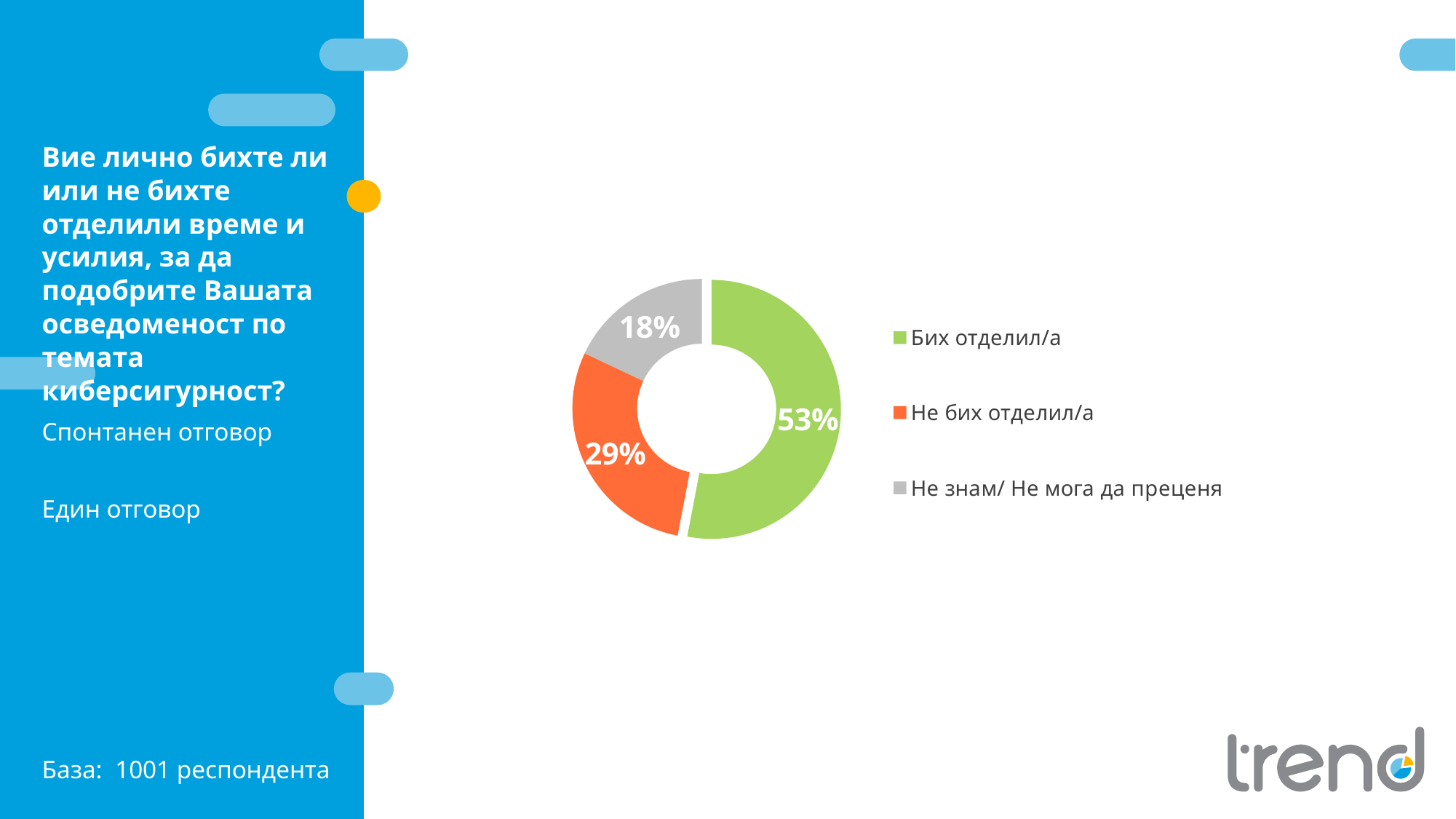
What kind of chart is shown on the slide? Pie (doughnut) chart What is the difference in percentage points between "Не бих отделил/а" and "Не знам/ Не мога да преценя"? 11 What share of respondents answered "Не бих отделил/а"? 29% What colour is the slice for "Не бих отделил/а"? Orange Which answer category has the largest share? Бих отделил/а Which answer category has the smallest share? Не знам/ Не мога да преценя What share of respondents answered "Бих отделил/а"? 53% How many categories does the chart show? 3 How many respondents form the base of the survey shown on the slide? 1001 Which is larger: the share for "Не бих отделил/а" or for "Не знам/ Не мога да преценя"? Не бих отделил/а What share of respondents answered "Не знам/ Не мога да преценя"? 18% What is the difference in percentage points between "Бих отделил/а" and "Не бих отделил/а"? 24